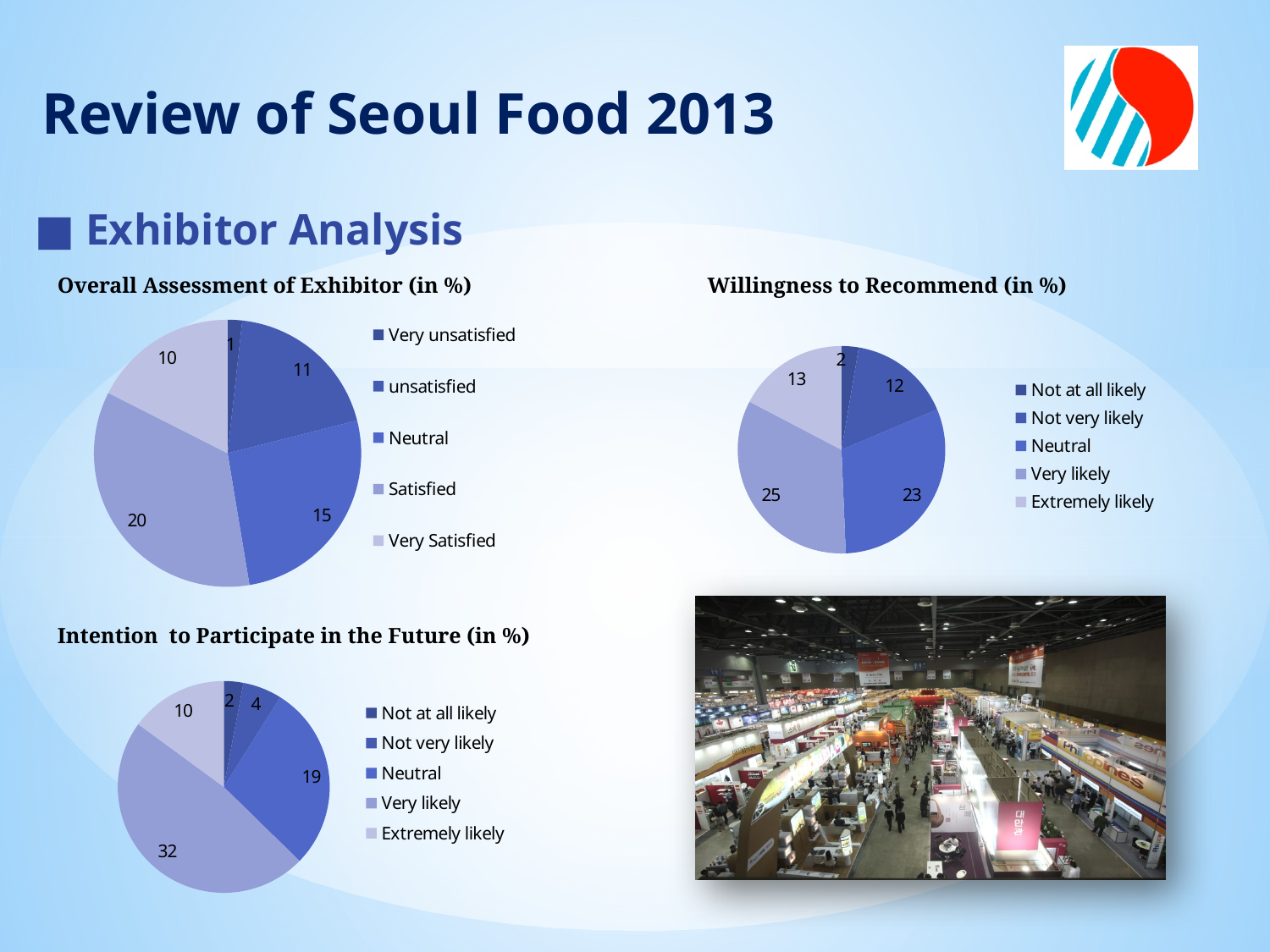
In the 'Overall Assessment of Exhibitor (in %)' chart, which category has the smallest slice? Very unsatisfied What type of chart is the 'Intention to Participate in the Future (in %)' chart? Pie chart In the 'Intention to Participate in the Future (in %)' chart, which category has the smallest slice? Not at all likely How many pie charts are shown on the slide? 3 In the 'Overall Assessment of Exhibitor (in %)' chart, what is the value for Satisfied? 20 In the 'Willingness to Recommend (in %)' chart, which is larger, Not very likely or Extremely likely? Extremely likely In the 'Overall Assessment of Exhibitor (in %)' chart, what is the difference between the Neutral and unsatisfied values? 4 In the 'Willingness to Recommend (in %)' chart, what is the value for Neutral? 23 In the 'Intention to Participate in the Future (in %)' chart, what is the difference between the Very likely and Neutral values? 13 In the 'Intention to Participate in the Future (in %)' chart, what is the value for Very likely? 32 In the 'Willingness to Recommend (in %)' chart, which category has the largest slice? Very likely How many categories does the 'Willingness to Recommend (in %)' chart show? 5